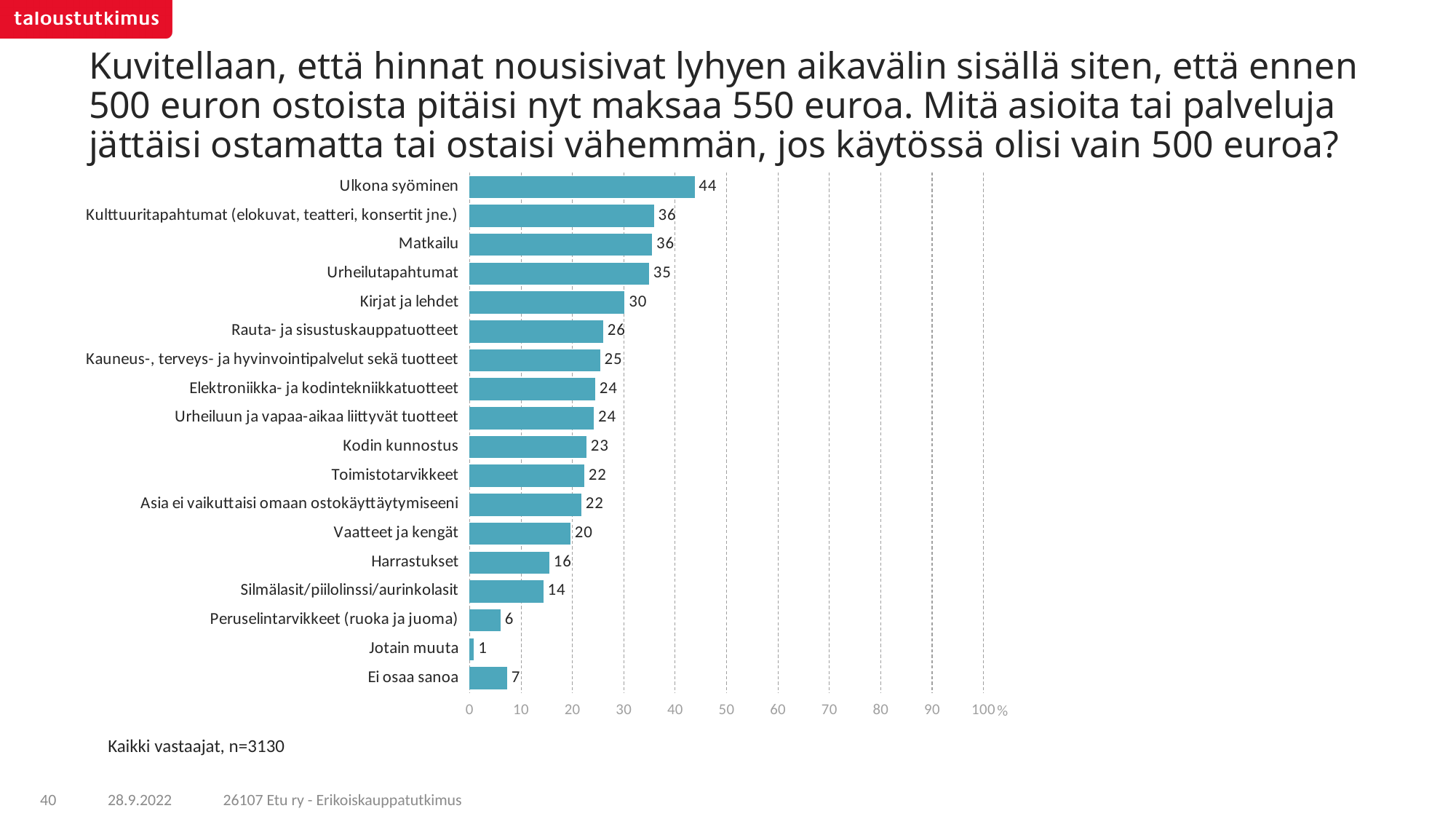
Which category has the highest value? Ulkona syöminen What is the value for Ei osaa sanoa? 7 Is the value for Urheilutapahtumat greater or less than 30? greater What is the number of respondents stated below the chart? n=3130 What is the value for Peruselintarvikkeet (ruoka ja juoma)? 6 Which is larger, the value for Harrastukset or the value for Silmälasit/piilolinssi/aurinkolasit? Harrastukset What is the value for Ulkona syöminen? 44 What is the difference between the values for Ulkona syöminen and Matkailu? 8 What kind of chart is shown on the slide? bar chart How many categories are shown in the chart? 18 What is the value for Kirjat ja lehdet? 30 Which category has the lowest value? Jotain muuta